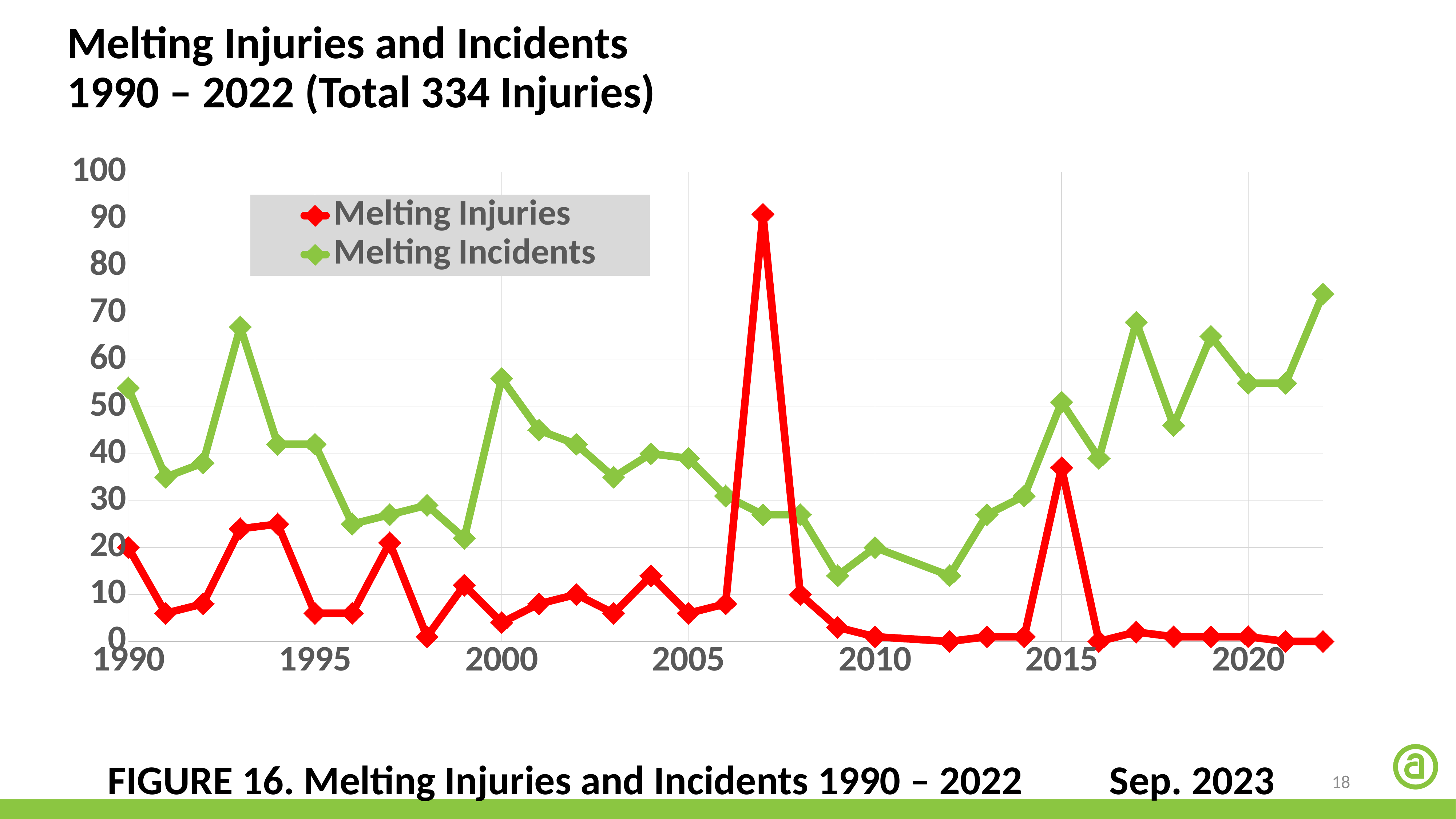
Is the value for Melting Injuries in 2007 greater or less than 80? greater Is the value for Melting Incidents in 2009 greater or less than 20? less Does the Melting Incidents series rise or fall between 2012 and 2015? Rise Is the value for Melting Injuries in 2015 greater or less than 30? greater In which year does the Melting Incidents series reach its highest value? 2022 How many series does the legend list? 2 In which year does the Melting Injuries series reach its highest value? 2007 What kind of chart is shown on the slide? Line chart Which colour is used for the Melting Injuries line? Red In 2007, which series has the larger value, Melting Injuries or Melting Incidents? Melting Injuries What are the two series named in the legend? Melting Injuries and Melting Incidents